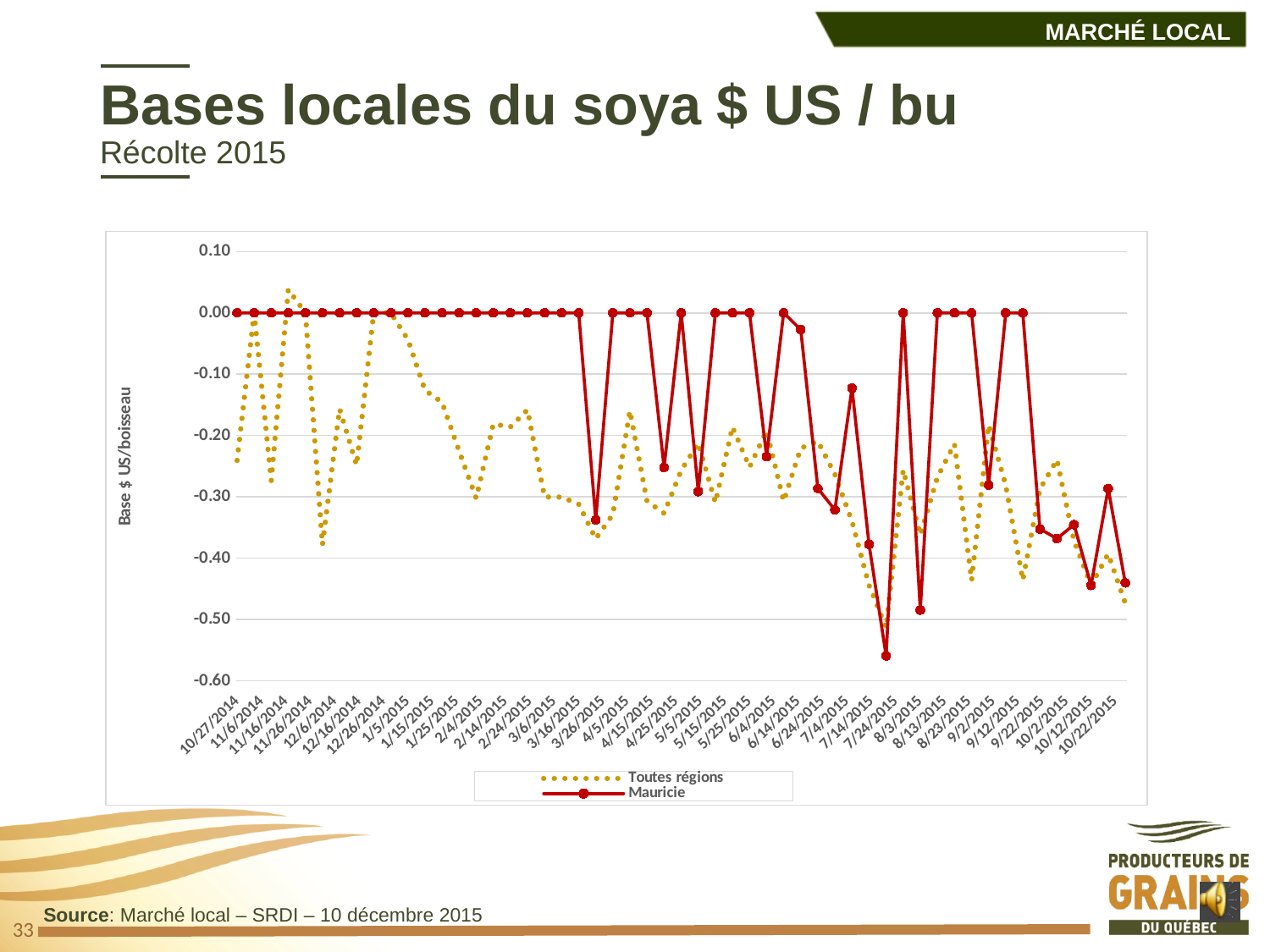
Is the Mauricie value on 3/26/2015 greater or less than -0.30? less Is the Mauricie value on 7/24/2015 greater or less than -0.50? less How many series does the legend list? 2 On which date does the Mauricie series reach its lowest value? 7/24/2015 What is the Mauricie value on 10/27/2014? 0.00 What kind of chart is shown on the slide? Line chart On 10/27/2014, which series has the higher value, Mauricie or Toutes régions? Mauricie What is the Mauricie value on 1/5/2015? 0.00 What is the label on the vertical axis of the chart? Base $ US/boisseau Overall, does the Mauricie series rise or fall from 10/27/2014 to 10/22/2015? Fall What are the two series named in the legend? Toutes régions and Mauricie